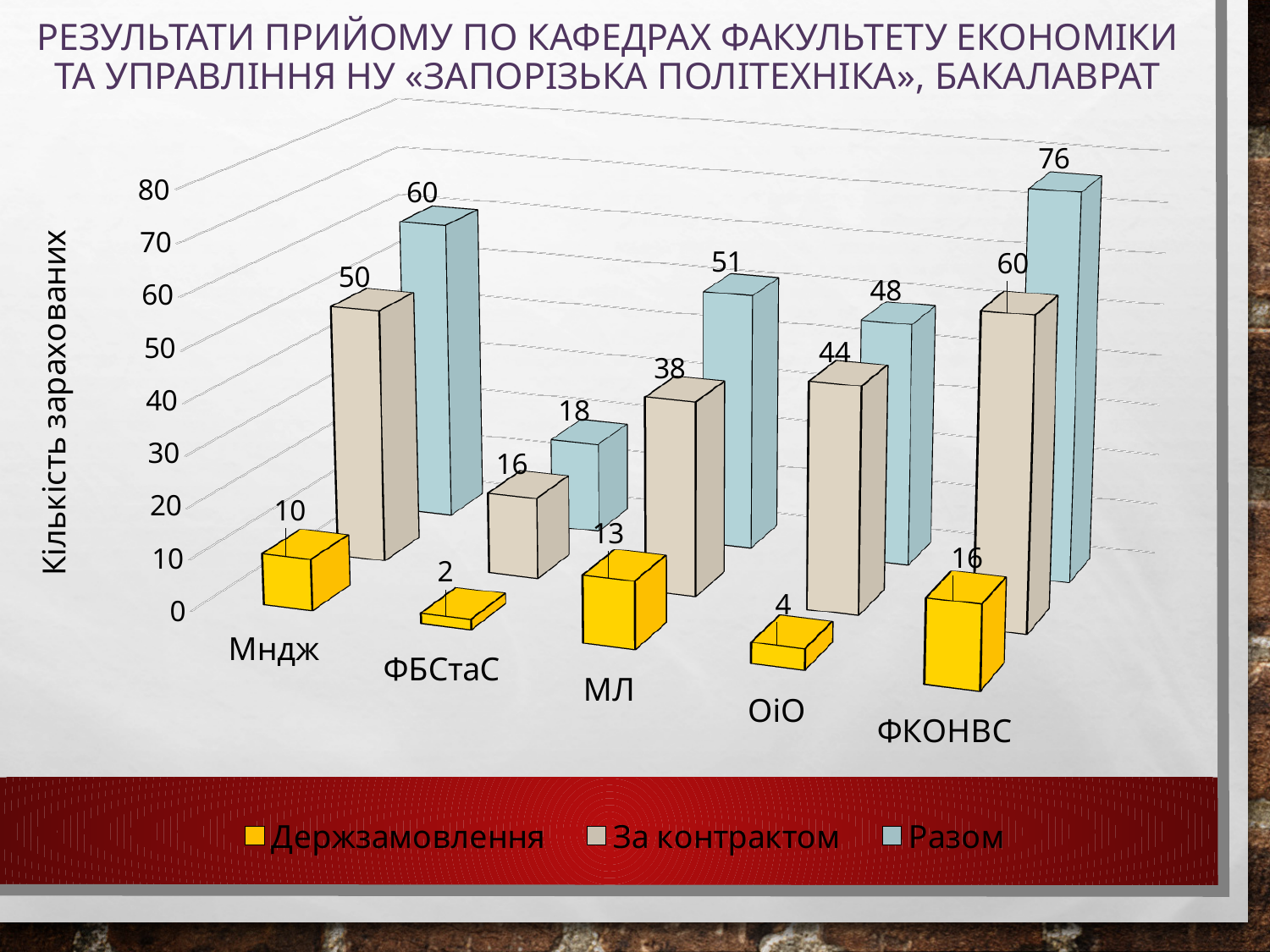
Which is larger: За контрактом for ОіО or За контрактом for МЛ? ОіО How many categories are shown on the x axis? 5 What is the value of За контрактом for МЛ? 38 Which category has the lowest Держзамовлення value? ФБСтаС What is the value of Держзамовлення for Мндж? 10 What is the value of Держзамовлення for ОіО? 4 What is the difference between the Разом values for ФКОНВС and Мндж? 16 What is the label of the vertical axis? Кількість зарахованих What is the value of Разом for ФКОНВС? 76 What kind of chart is shown on the slide? Bar chart Which category has the highest Разом value? ФКОНВС How many series does the legend list? 3